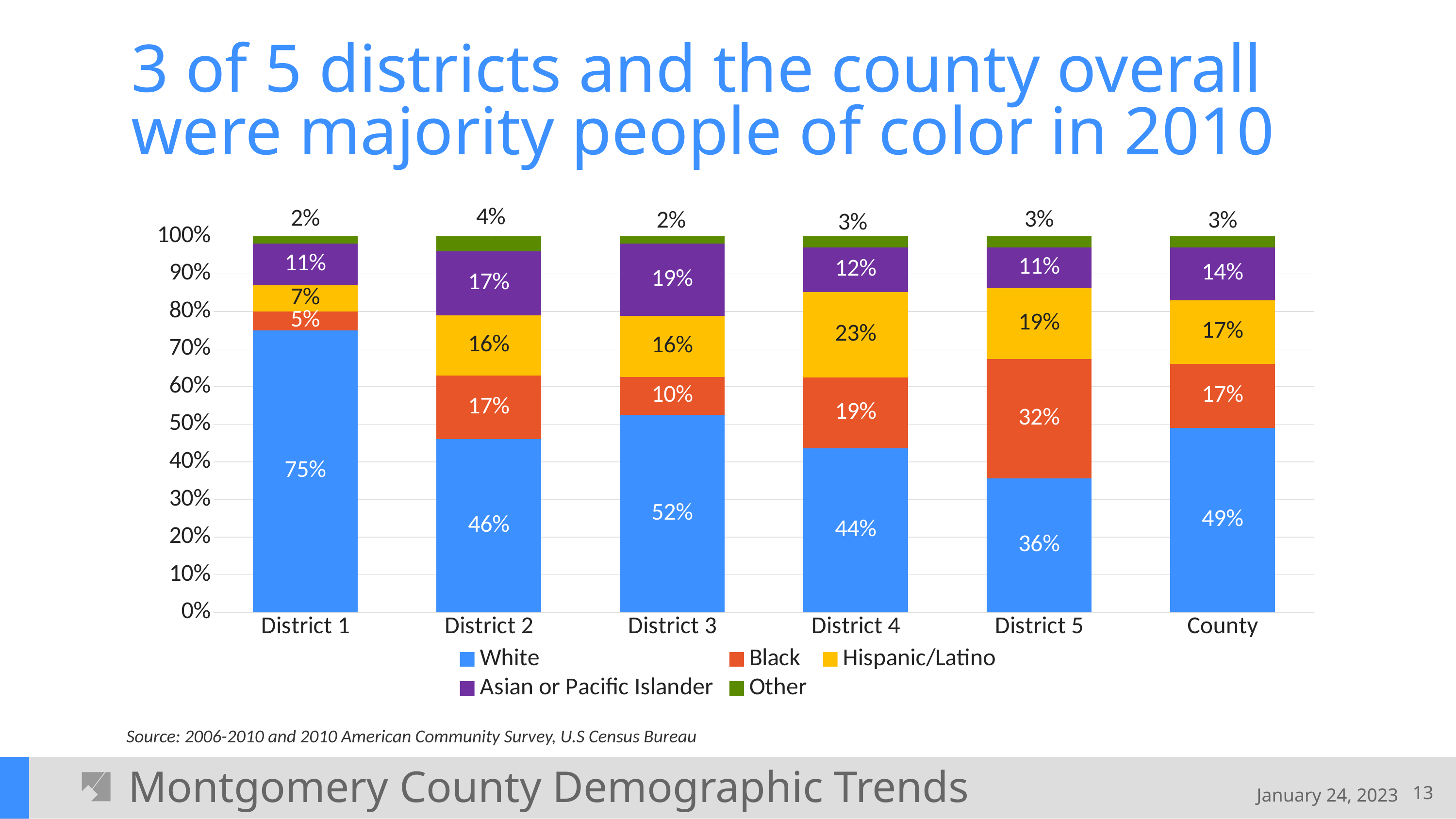
What is the White share for District 1? 75% How many series does the legend list? 5 What is the difference between the White share in District 1 and District 5? 39% What is the Other share for District 2? 4% What is the Asian or Pacific Islander share for the County? 14% What is the Hispanic/Latino share for District 4? 23% Which category has the lowest White share? District 5 What kind of chart is shown on the slide? Stacked bar chart What is the Black share for District 5? 32% How many categories are shown on the x axis? 6 Which category has the highest White share? District 1 Which is larger, the Black share in District 4 or in District 3? District 4